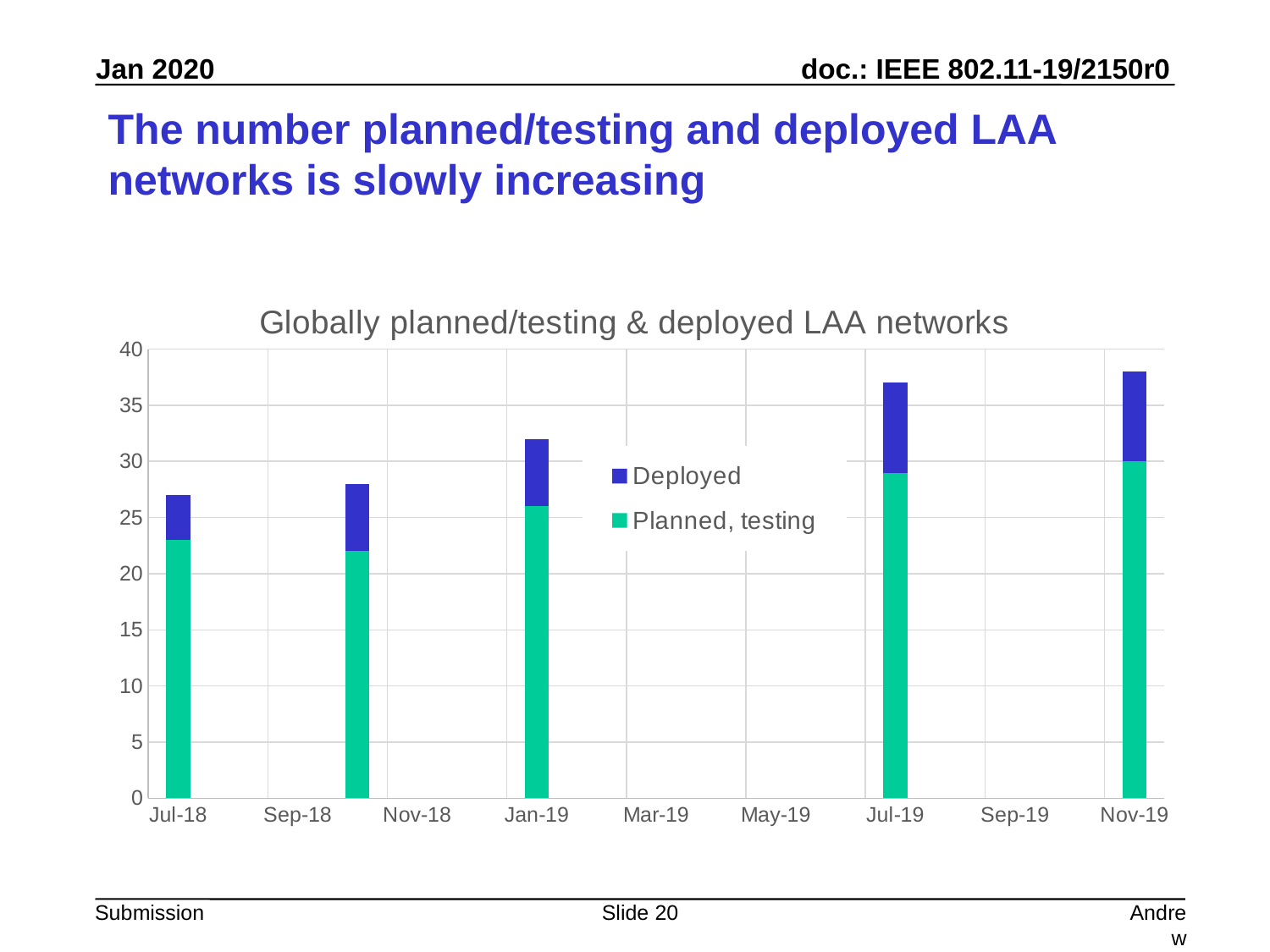
What is the title of the chart? Globally planned/testing & deployed LAA networks How many bars are plotted in the chart? 5 What kind of chart is shown on the slide? Stacked bar chart How many series does the legend list? 2 Do the total bar heights generally rise or fall from Jul-18 to Nov-19? rise Which colour represents the Deployed series? Blue Is the total height of the Nov-19 bar greater or less than 40? less Is the Planned, testing value for Jan-19 greater or less than 30? less Is the total height of the Jul-18 bar greater or less than 25? greater Which bar is taller in total, Jan-19 or Jul-19? Jul-19